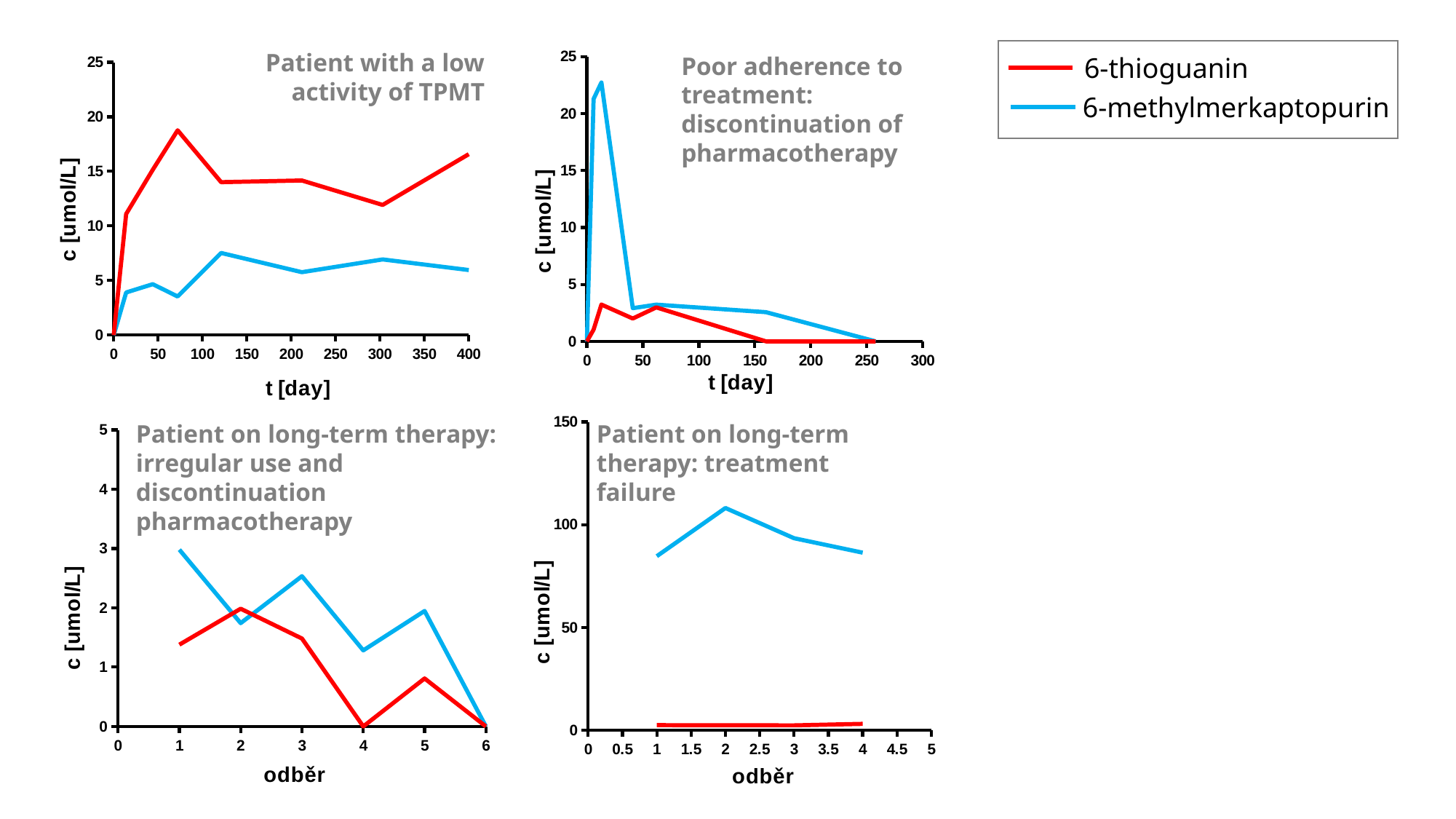
In the bottom-right chart "Patient on long-term therapy: treatment failure", is the 6-methylmerkaptopurin value at odběr 2 greater or less than 100? greater In the bottom-right chart "Patient on long-term therapy: treatment failure", which series has the higher values, 6-thioguanin or 6-methylmerkaptopurin? 6-methylmerkaptopurin In the bottom-left chart "Patient on long-term therapy: irregular use and discontinuation pharmacotherapy", is the 6-methylmerkaptopurin value at odběr 3 greater or less than 2? greater Which colour represents 6-thioguanin in the legend? red In the top-left chart "Patient with a low activity of TPMT", which series has the higher values across the whole time range, 6-thioguanin or 6-methylmerkaptopurin? 6-thioguanin In the top-left chart "Patient with a low activity of TPMT", is the peak value of 6-thioguanin greater or less than 15? greater How many series does the legend on the slide list? 2 In the bottom-left chart "Patient on long-term therapy: irregular use and discontinuation pharmacotherapy", how many odběr points are plotted for each series? 6 What kind of chart is the top-left chart titled "Patient with a low activity of TPMT"? line chart In the top-right chart "Poor adherence to treatment: discontinuation of pharmacotherapy", do the 6-methylmerkaptopurin values rise or fall after day 50? fall